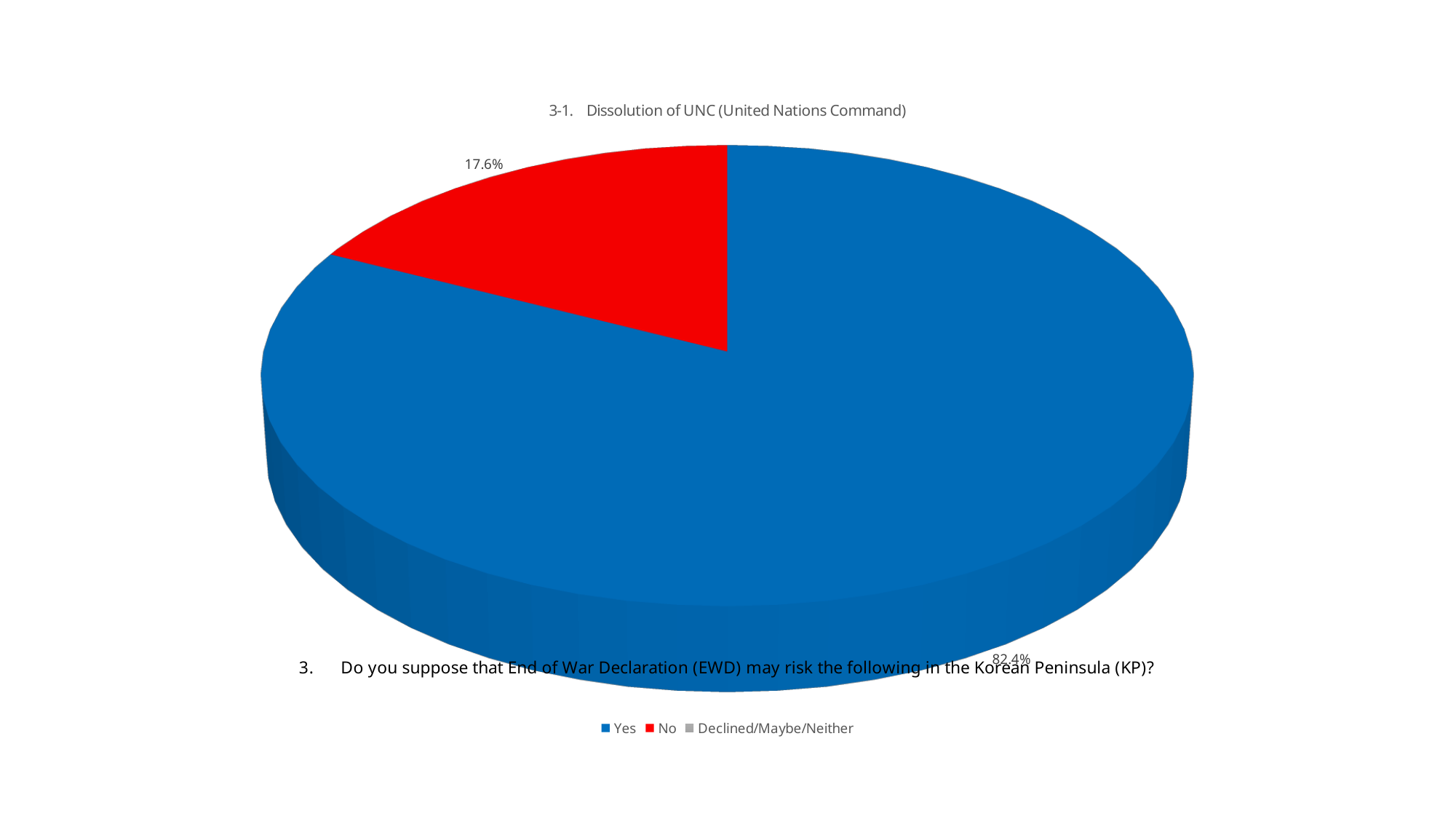
What percentage of the pie is labelled for the "Yes" slice? 82.4% What is the difference in percentage points between the "Yes" and "No" shares? 64.8 What type of chart is shown on the slide? Pie chart Is the share for "Yes" larger or smaller than the share for "No"? Larger How many entries does the legend list? 3 Which category has the largest share of the pie? Yes What colour is the "No" slice? Red What percentage of the pie is labelled for the "No" slice? 17.6% Is the share for "No" greater or less than 20%? less Which of the two visible slices, "Yes" or "No", is smaller? No Is the share for "Yes" greater or less than 80%? greater What is the title of the chart? 3-1. Dissolution of UNC (United Nations Command)